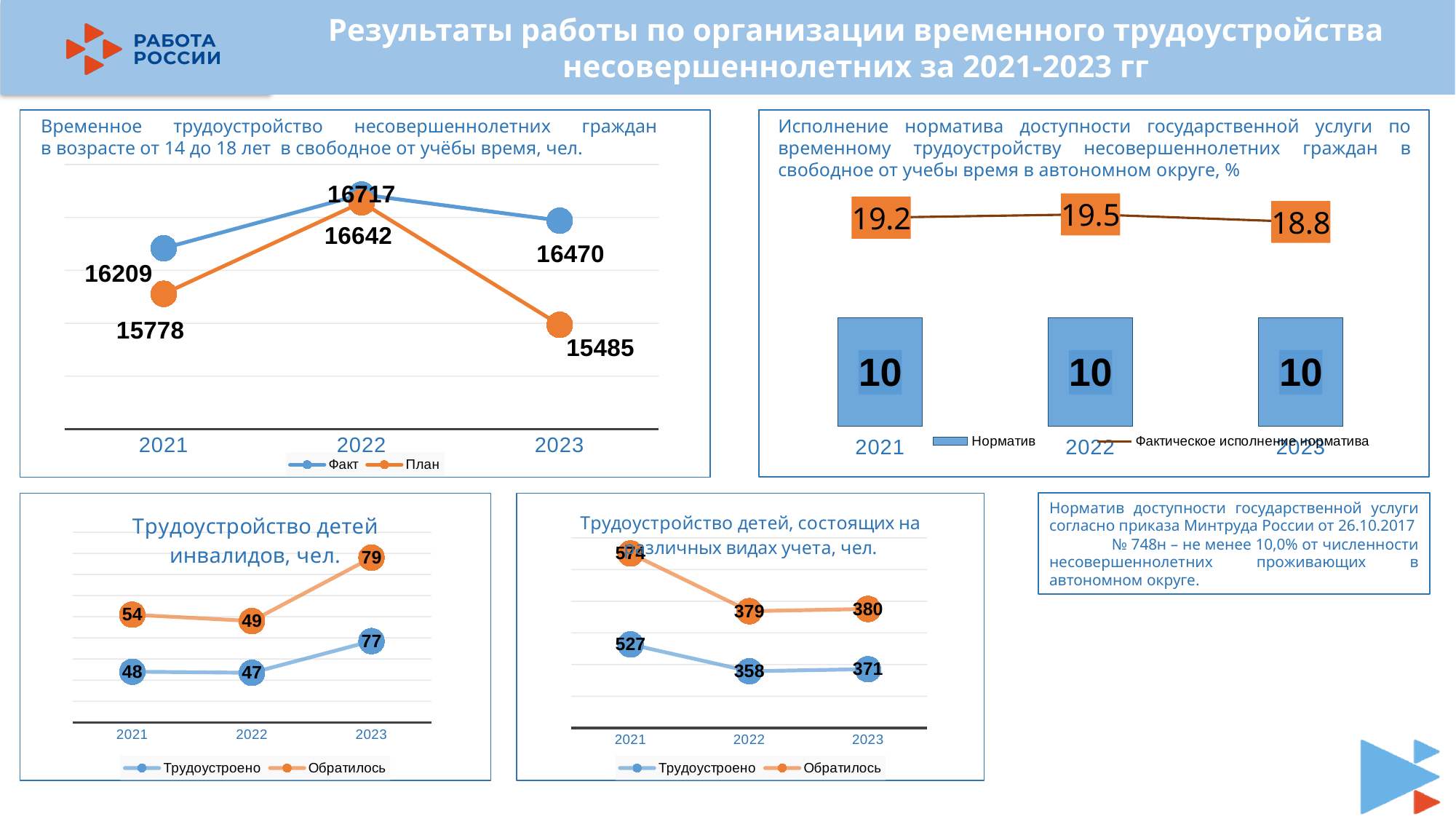
On the top-right chart (Исполнение норматива доступности), what is the Норматив value for 2021? 10 On the bottom-middle chart (Трудоустройство детей, состоящих на различных видах учета), what is the Трудоустроено value for 2022? 358 On the bottom-left chart (Трудоустройство детей инвалидов), what is the Обратилось value for 2023? 79 On the top-left chart (Временное трудоустройство несовершеннолетних граждан), what is the difference between Факт and План in 2021? 431 On the top-right chart (Исполнение норматива доступности), in which year is the Фактическое исполнение норматива value lowest? 2023 On the bottom-left chart (Трудоустройство детей инвалидов), what is the difference between Обратилось and Трудоустроено in 2021? 6 On the top-left chart (Временное трудоустройство несовершеннолетних граждан), in which year is the План value lowest? 2023 On the top-right chart (Исполнение норматива доступности), what is the Фактическое исполнение норматива value for 2022? 19.5 How many series does the legend of the top-left chart (Временное трудоустройство несовершеннолетних граждан) list? 2 On the bottom-middle chart (Трудоустройство детей, состоящих на различных видах учета), which is larger: Обратилось in 2021 or Обратилось in 2023? 2021 On the top-left chart (Временное трудоустройство несовершеннолетних граждан), what is the План value for 2023? 15485 On the top-left chart (Временное трудоустройство несовершеннолетних граждан), what is the Факт value for 2022? 16717